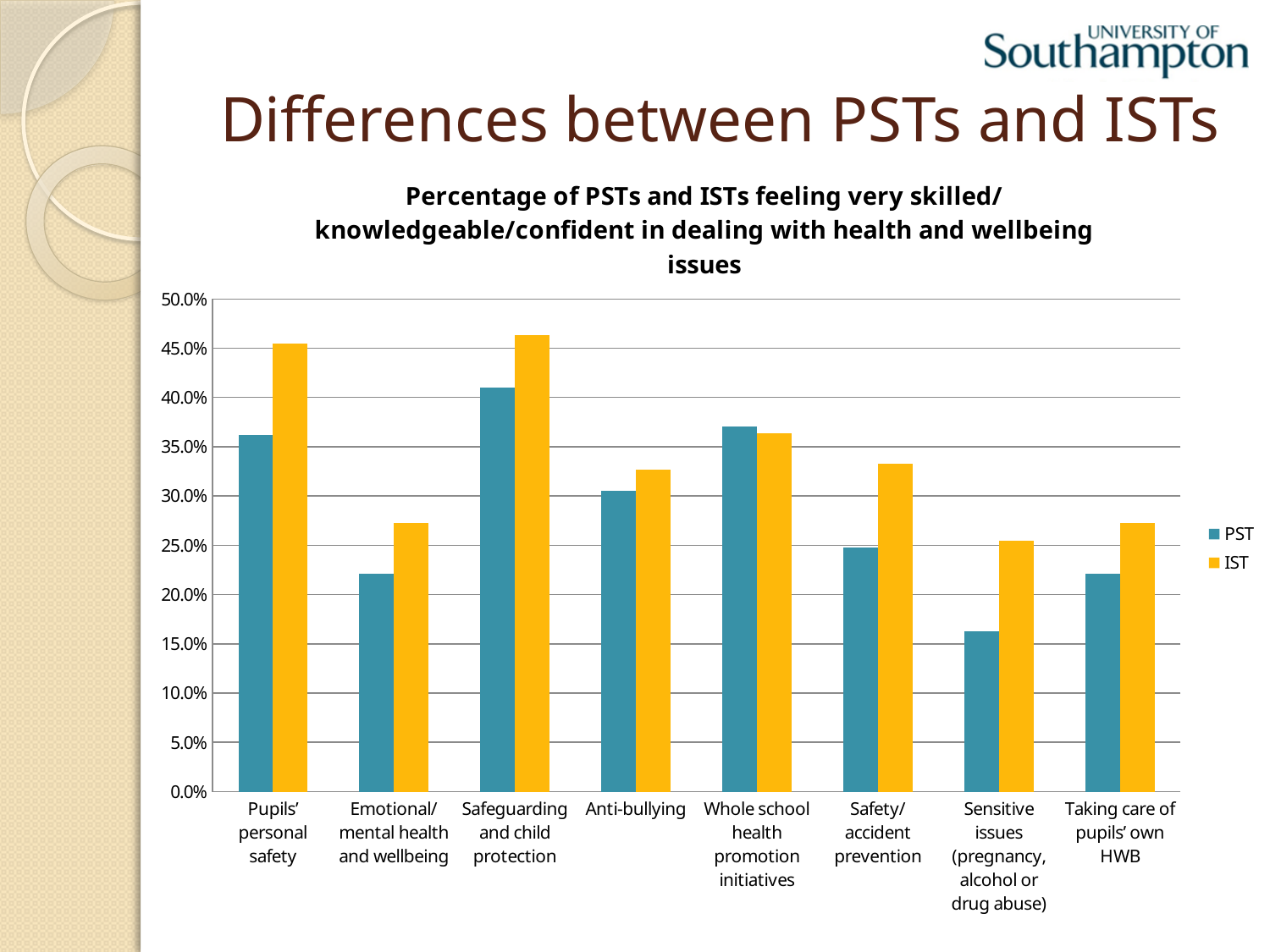
Which colour represents the IST series in the legend? yellow/orange For Pupils' personal safety, which is larger, the PST value or the IST value? IST Is the PST value for Sensitive issues (pregnancy, alcohol or drug abuse) greater or less than 20.0%? less Is the IST value for Pupils' personal safety greater or less than 40.0%? greater Is the IST value for Safety/accident prevention greater or less than 30.0%? greater Which category has the highest PST value? Safeguarding and child protection Which category has the lowest PST value? Sensitive issues (pregnancy, alcohol or drug abuse) Which category has the lowest IST value? Sensitive issues (pregnancy, alcohol or drug abuse) How many series does the legend list? 2 How many categories are shown on the x axis? 8 What kind of chart is shown on the slide? bar chart